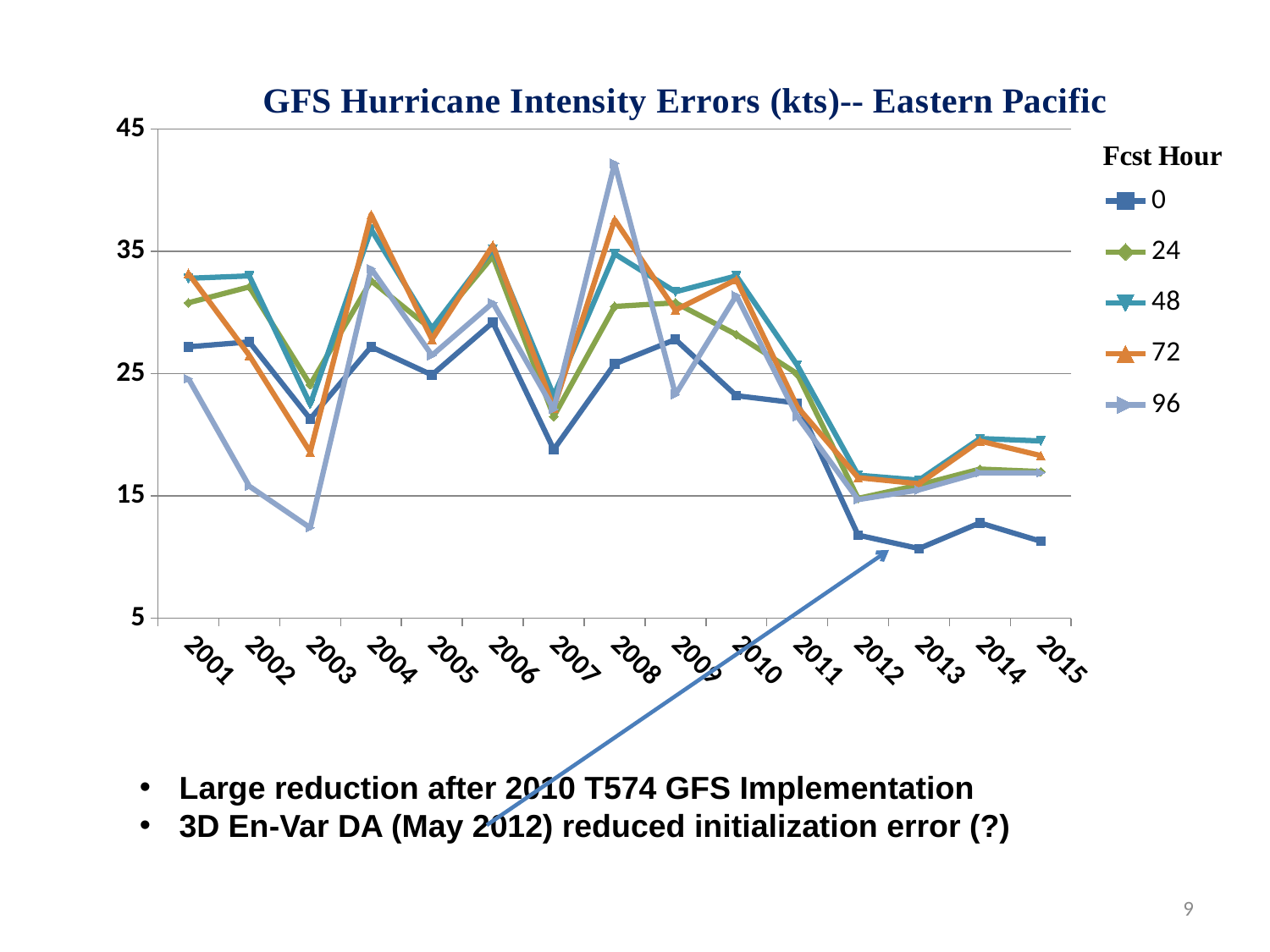
Is the value for the 96 forecast hour in 2008 greater or less than 35? greater How many years are plotted along the x axis? 15 Is the value for the 0 forecast hour in 2013 greater or less than 15? less Is the value for the 72 forecast hour in 2004 greater or less than 35? greater How many series does the legend list? 5 What is the title of the legend? Fcst Hour What kind of chart is shown on the slide? line chart What is the title of the chart? GFS Hurricane Intensity Errors (kts)-- Eastern Pacific In which year does the 96 forecast hour series reach its lowest value? 2003 In which year does the 96 forecast hour series reach its highest value? 2008 In 2008, which is larger: the value for the 96 forecast hour or the 0 forecast hour? 96